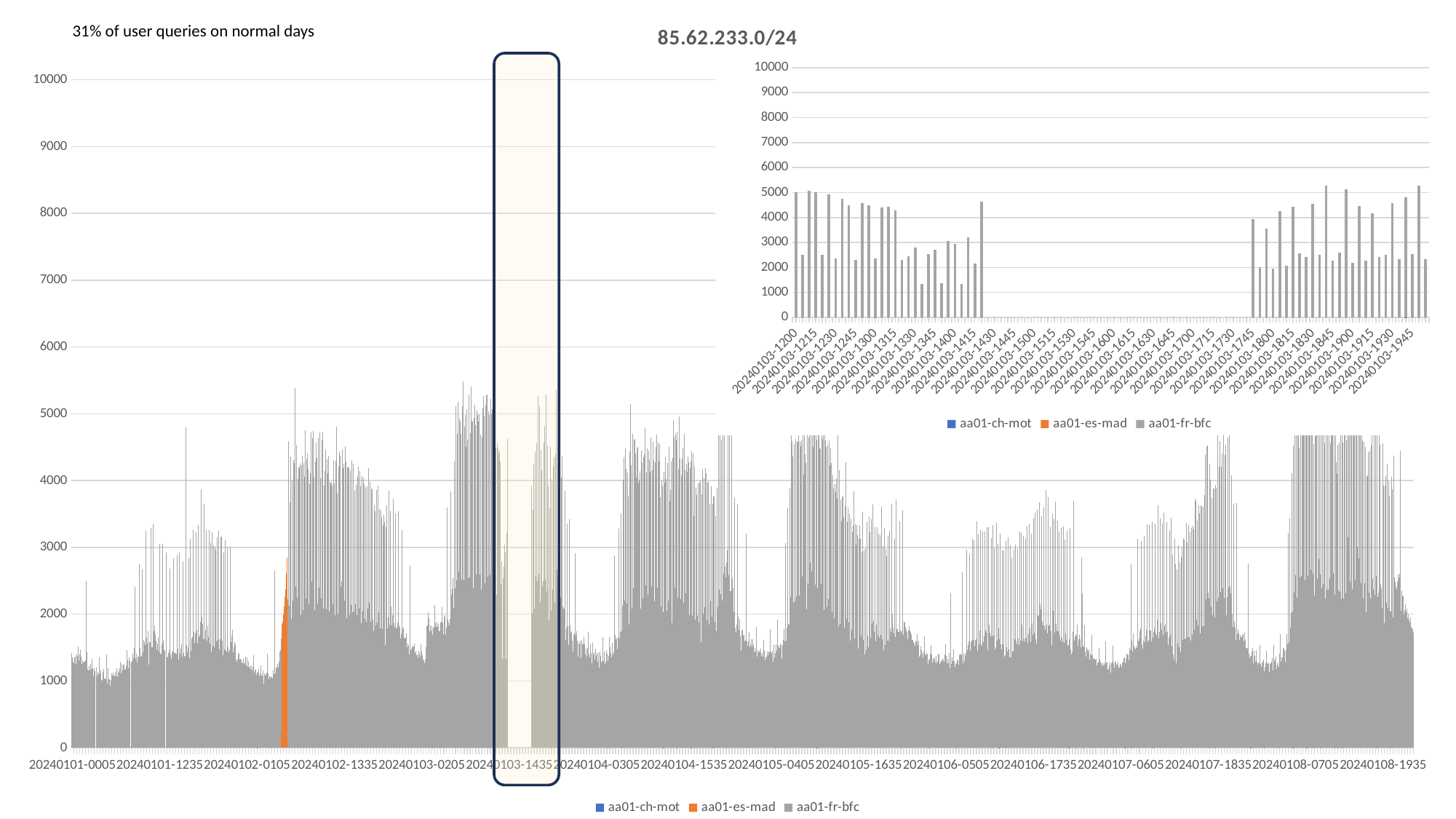
In the large chart on the left, which series is drawn in orange? aa01-es-mad In the inset chart titled 85.62.233.0/24, is the highest bar greater or less than 6000? less In the inset chart titled 85.62.233.0/24, is the value for 20240103-1700 greater or less than 1000? less What is the highest value shown on the y axis of the inset chart titled 85.62.233.0/24? 10000 How many series does the legend of the inset chart titled 85.62.233.0/24 list? 3 In the inset chart titled 85.62.233.0/24, is the value for 20240103-1945 greater or less than 1000? greater How many series does the legend of the large chart on the left list? 3 What is the title of the inset chart in the upper right of the slide? 85.62.233.0/24 What kind of chart is the large chart on the left of the slide? bar chart What kind of chart is the inset chart titled 85.62.233.0/24? bar chart